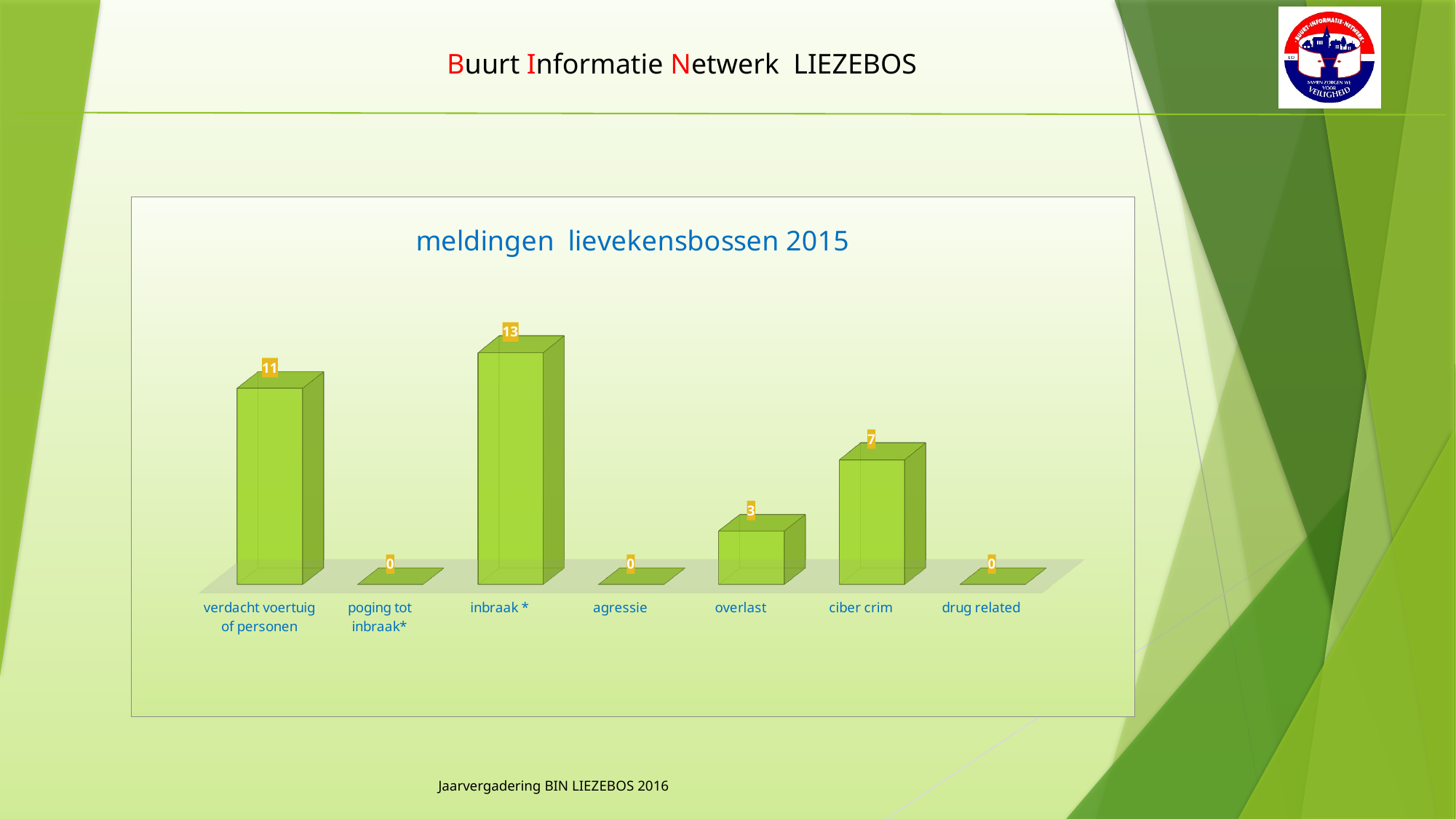
Which category has the highest value? inbraak * What is the difference between the values for inbraak * and verdacht voertuig of personen? 2 Which is larger, the value for ciber crim or the value for overlast? ciber crim What is the title of the chart? meldingen lievekensbossen 2015 What is the difference between the values for ciber crim and overlast? 4 What kind of chart is shown on the slide? bar chart What is the value for inbraak *? 13 What is the value for overlast? 3 What is the value for ciber crim? 7 How many categories are shown on the x axis? 7 What is the value for agressie? 0 What is the value for verdacht voertuig of personen? 11